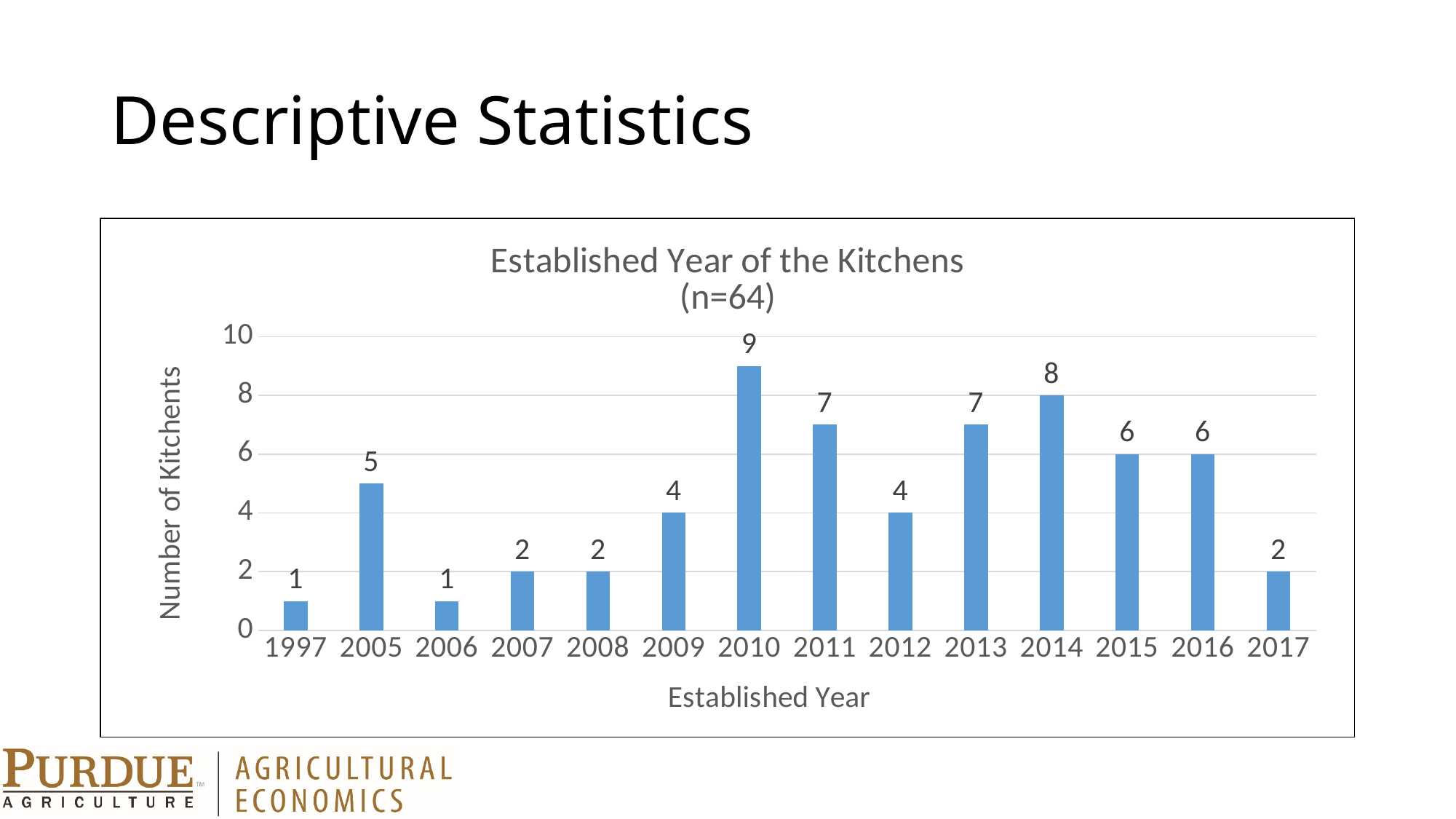
How many established years are shown on the x axis? 14 What is the difference between the number of kitchens established in 2010 and in 2012? 5 Which established year has the highest number of kitchens? 2010 Which year has more kitchens established, 2011 or 2015? 2011 What is the title of the chart? Established Year of the Kitchens (n=64) What is the label of the y axis? Number of Kitchents What kind of chart is shown on the slide? Bar chart How many kitchens were established in 2005? 5 Do the values rise or fall from 2012 to 2014? Rise How many kitchens were established in 2010? 9 How many kitchens were established in 2014? 8 What is the difference between the number of kitchens established in 2014 and in 2017? 6